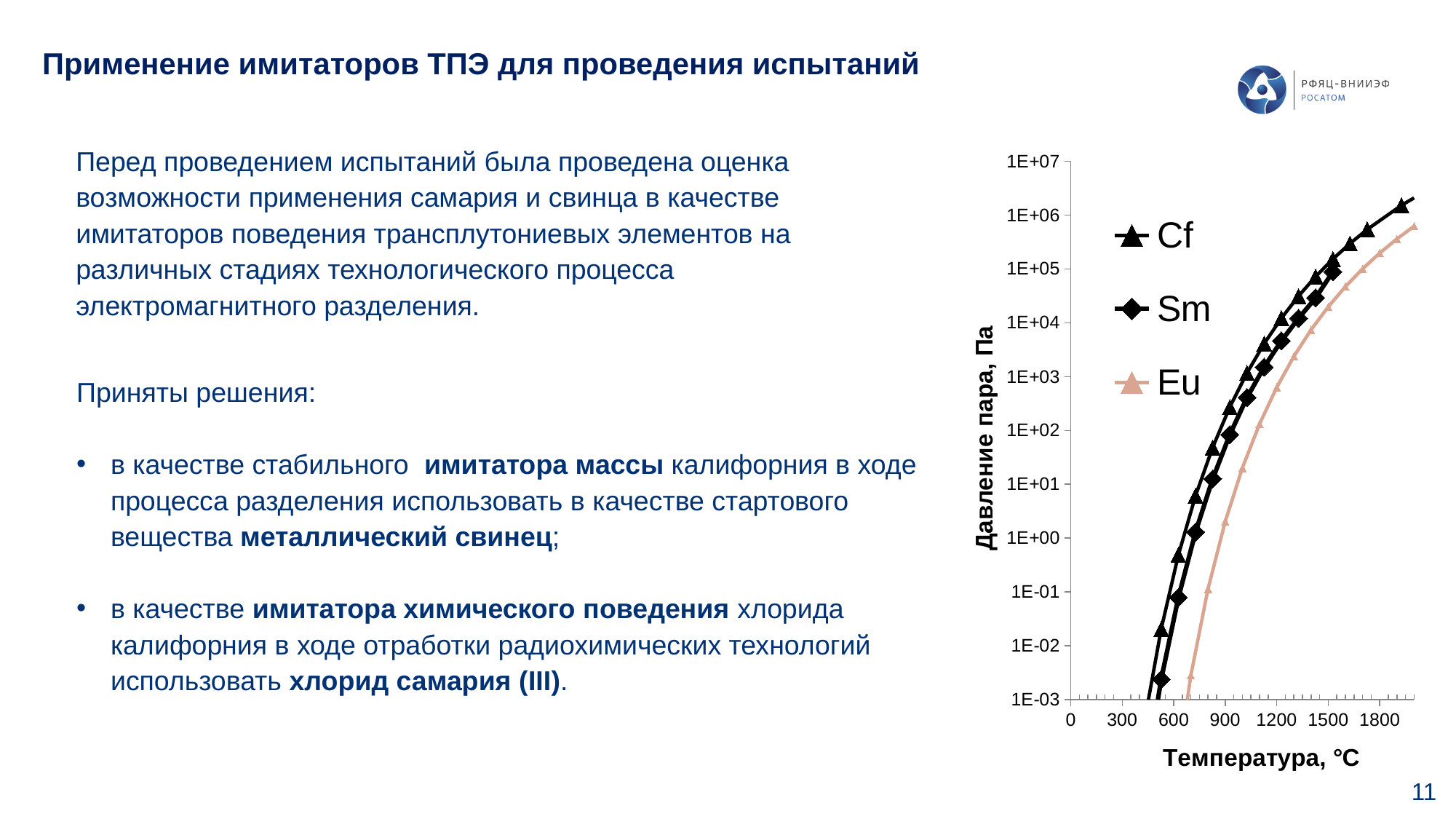
Is the vapour pressure for Eu at 1800 °C greater or less than 1E+04 Pa? greater Is the vapour pressure for Eu at 600 °C greater or less than 1E-01 Pa? less Is the vapour pressure for Cf at 1800 °C greater or less than 1E+05 Pa? greater How many series does the chart legend list? 3 What is the label of the vertical axis of the chart? Давление пара, Па Do the vapour pressure values rise or fall as temperature increases along the x axis? rise At 1200 °C, which series has the higher vapour pressure, Cf or Eu? Cf What is the highest tick value shown on the vertical axis of the chart? 1E+07 Which series has the lowest vapour pressure at 1500 °C? Eu Which series are listed in the chart legend? Cf, Sm, Eu What kind of chart is shown on the slide? line chart